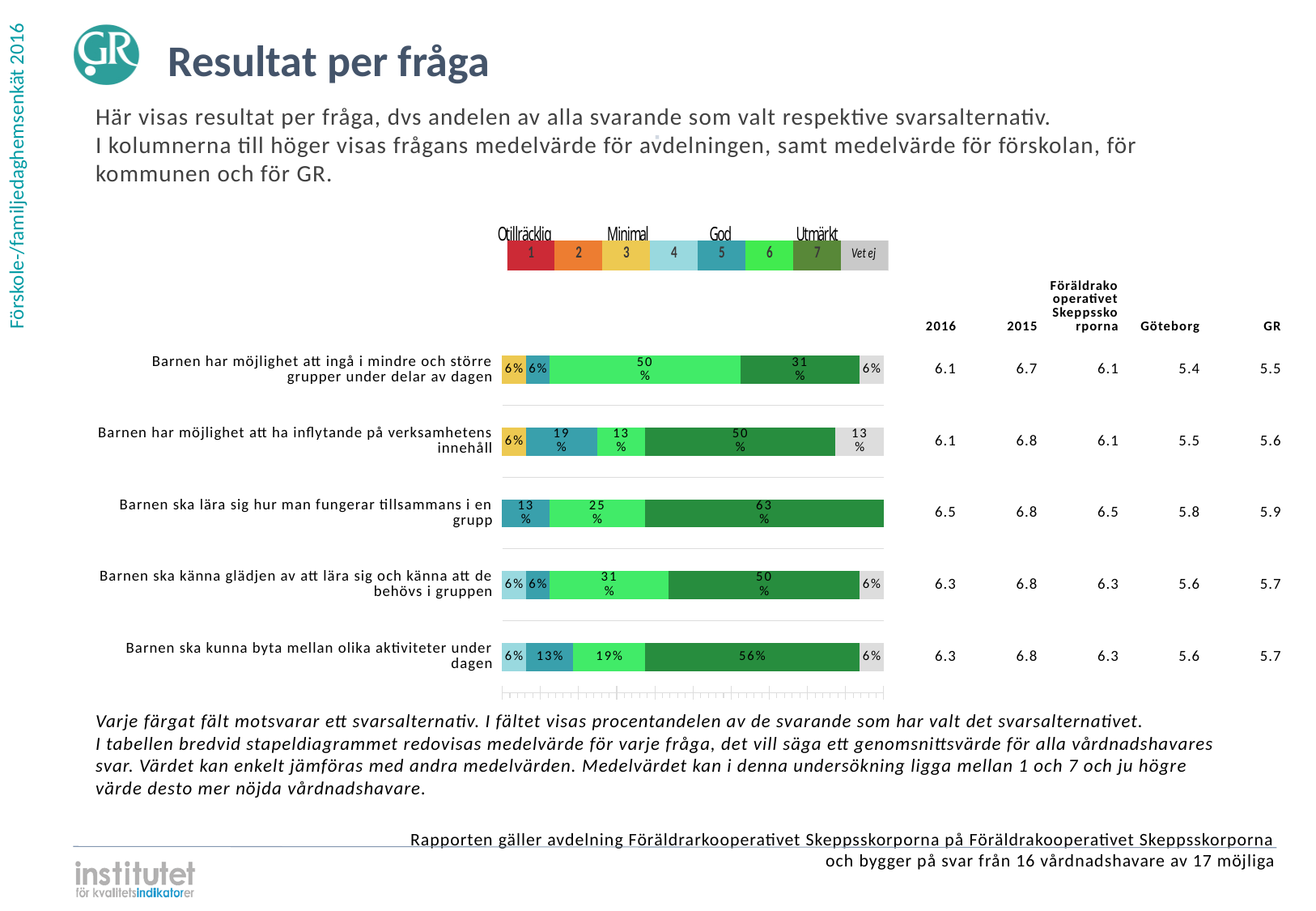
What kind of chart is shown on the slide? Stacked bar chart What percentage of respondents answered "Vet ej" for "Barnen har möjlighet att ha inflytande på verksamhetens innehåll"? 13% Which colour represents response option 7 (Utmärkt) in the chart? Dark green What percentage of respondents chose option 6 for "Barnen har möjlighet att ingå i mindre och större grupper under delar av dagen"? 50% How many response options does the legend above the chart list? 8 Which is larger: the option 6 share for "Barnen ska känna glädjen av att lära sig och känna att de behövs i gruppen" or the option 6 share for "Barnen ska kunna byta mellan olika aktiviteter under dagen"? Barnen ska känna glädjen av att lära sig och känna att de behövs i gruppen (31%) Which question has the largest share of respondents choosing option 7 (Utmärkt)? Barnen ska lära sig hur man fungerar tillsammans i en grupp What is the difference between the option 7 share for "Barnen ska lära sig hur man fungerar tillsammans i en grupp" (63%) and for "Barnen har möjlighet att ingå i mindre och större grupper under delar av dagen" (31%)? 32 percentage points How many questions (categories) are plotted in the bar chart? 5 What is the combined share of options 6 and 7 for "Barnen ska lära sig hur man fungerar tillsammans i en grupp"? 88% What percentage of respondents chose option 7 for "Barnen ska kunna byta mellan olika aktiviteter under dagen"? 56% What percentage of respondents chose option 7 (Utmärkt) for "Barnen ska lära sig hur man fungerar tillsammans i en grupp"? 63%